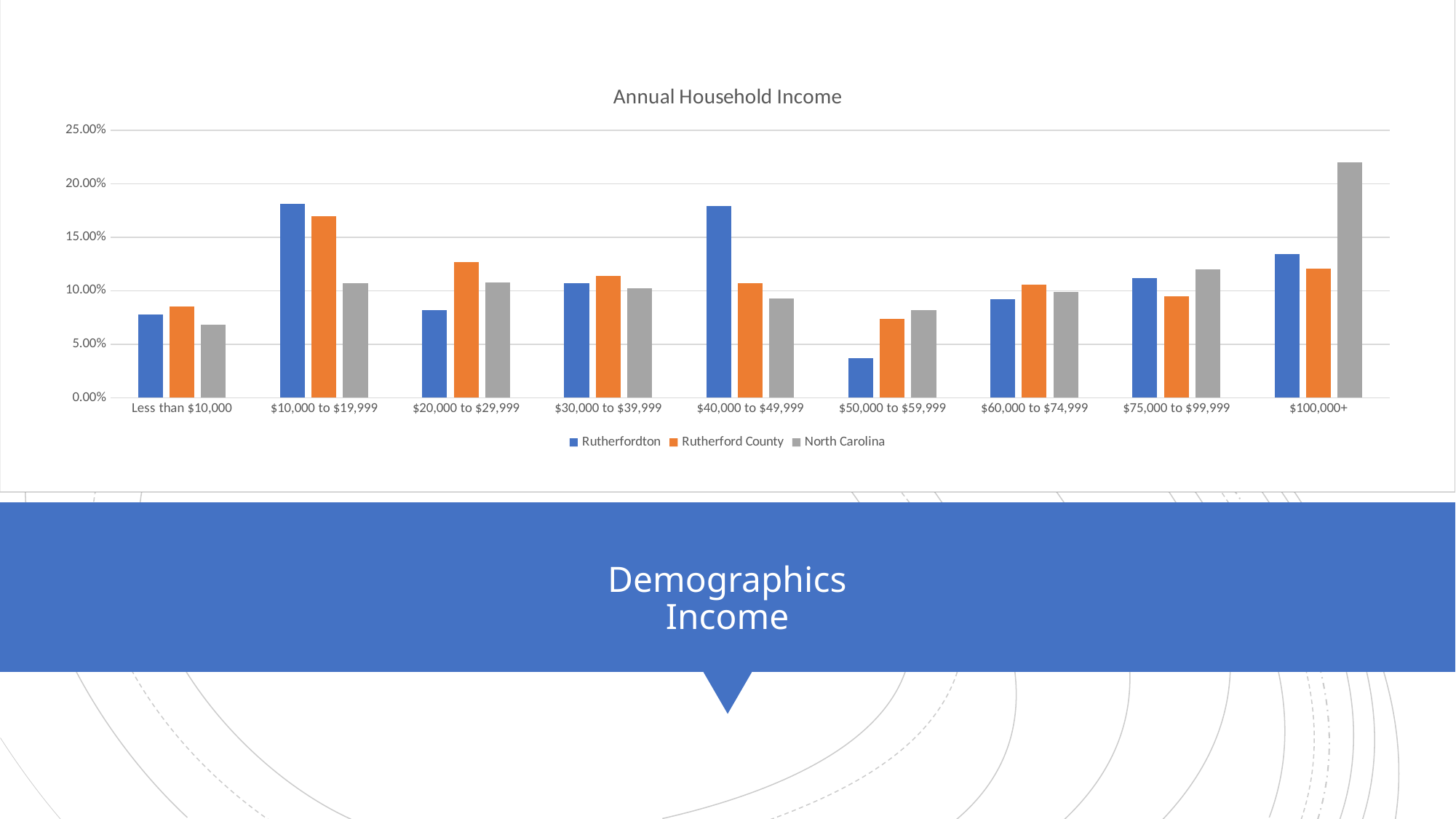
For $20,000 to $29,999, which is larger: Rutherfordton or Rutherford County? Rutherford County What is the title of the chart? Annual Household Income Which income category has the lowest value for Rutherfordton? $50,000 to $59,999 How many income categories are shown on the x axis? 9 Which income category has the highest value for Rutherford County? $10,000 to $19,999 Is the North Carolina value for $100,000+ greater or less than 20.00%? greater Is the Rutherfordton value for $40,000 to $49,999 greater or less than 15.00%? greater What kind of chart is shown on the slide? Bar chart Which colour represents North Carolina in the chart? Gray Which income category has the highest value for North Carolina? $100,000+ Is the Rutherfordton value for $50,000 to $59,999 greater or less than 5.00%? less How many series does the legend list? 3